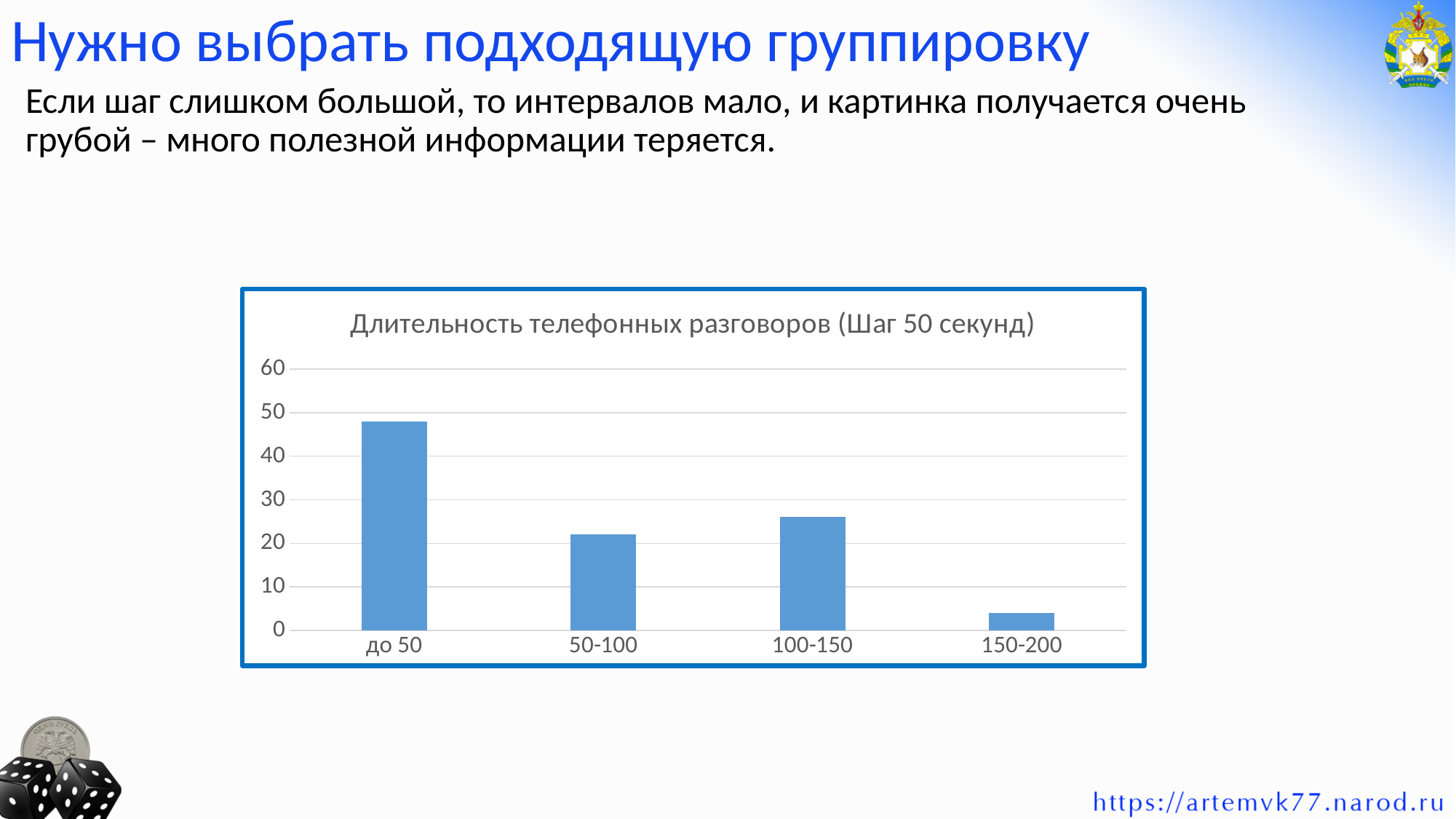
Is the value for до 50 greater or less than 40? greater Is the value for 100-150 greater or less than 30? less Is the value for 50-100 greater or less than 30? less What is the highest tick value shown on the vertical axis? 60 What is the title of the chart? Длительность телефонных разговоров (Шаг 50 секунд) Which is larger, the value for 50-100 or the value for 100-150? 100-150 How many categories are shown on the x axis of the chart? 4 Which is larger, the value for до 50 or the value for 150-200? до 50 Which category has the highest value? до 50 Which category has the lowest value? 150-200 What kind of chart is shown on the slide? bar chart